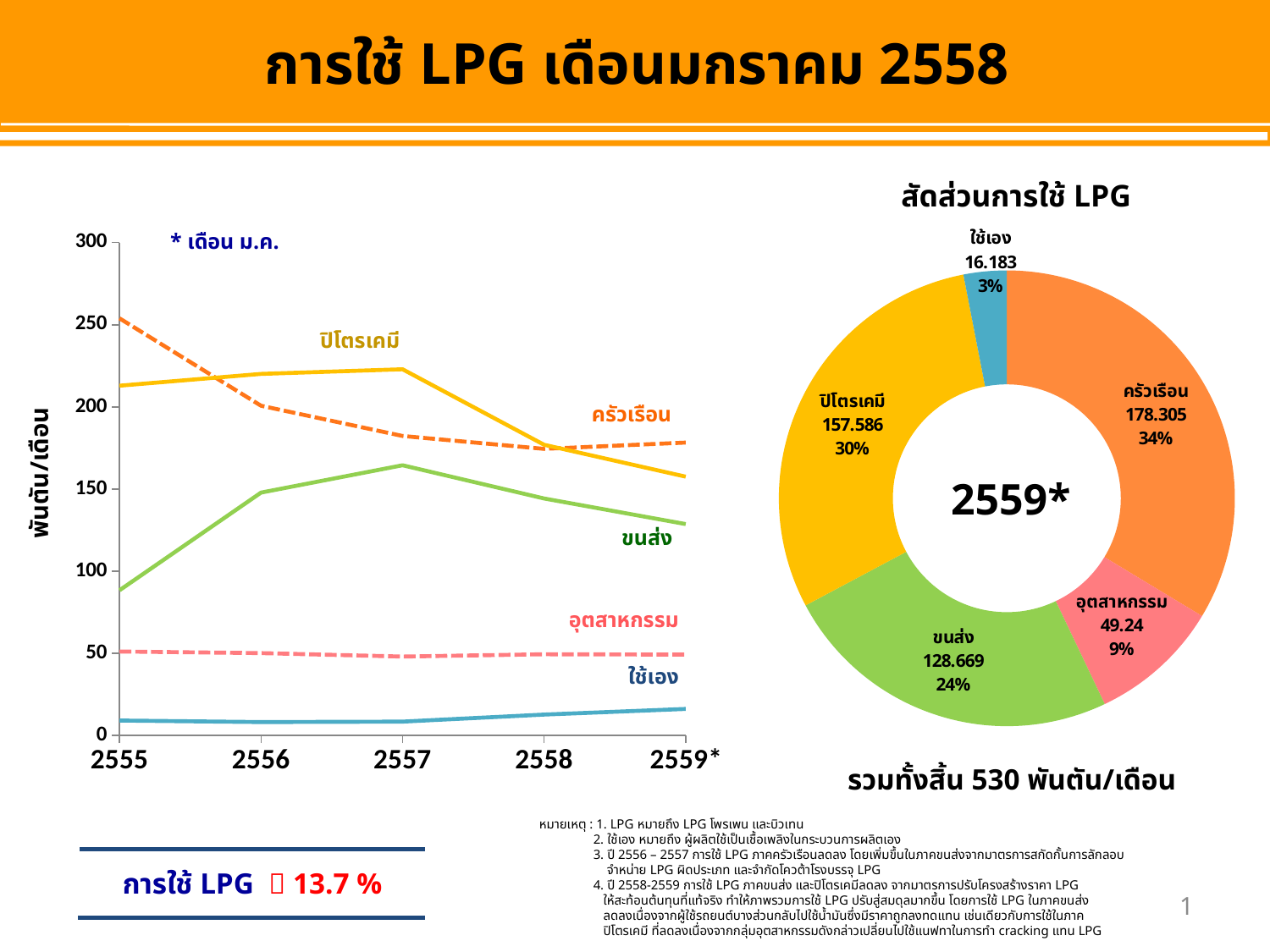
In the line chart on the left, is the value for ปิโตรเคมี in 2557 greater or less than 200? greater In the doughnut chart titled สัดส่วนการใช้ LPG, what is the value shown for ครัวเรือน? 178.305 In the doughnut chart titled สัดส่วนการใช้ LPG, how many categories are shown? 5 In the line chart on the left, does the ครัวเรือน line rise or fall from 2555 to 2558? fall What kind of chart is the chart on the left side of the slide? Line chart In the doughnut chart titled สัดส่วนการใช้ LPG, what is the value shown for อุตสาหกรรม? 49.24 In the doughnut chart titled สัดส่วนการใช้ LPG, what share of LPG use does ขนส่ง account for? 24% In the doughnut chart titled สัดส่วนการใช้ LPG, what is the difference between the values for ครัวเรือน and ปิโตรเคมี? 20.719 What kind of chart is the chart on the right side of the slide? Doughnut (pie) chart In the line chart on the left, how many years are shown on the x axis? 5 In the doughnut chart titled สัดส่วนการใช้ LPG, which category has the largest share? ครัวเรือน In the doughnut chart titled สัดส่วนการใช้ LPG, which category has the smallest share? ใช้เอง